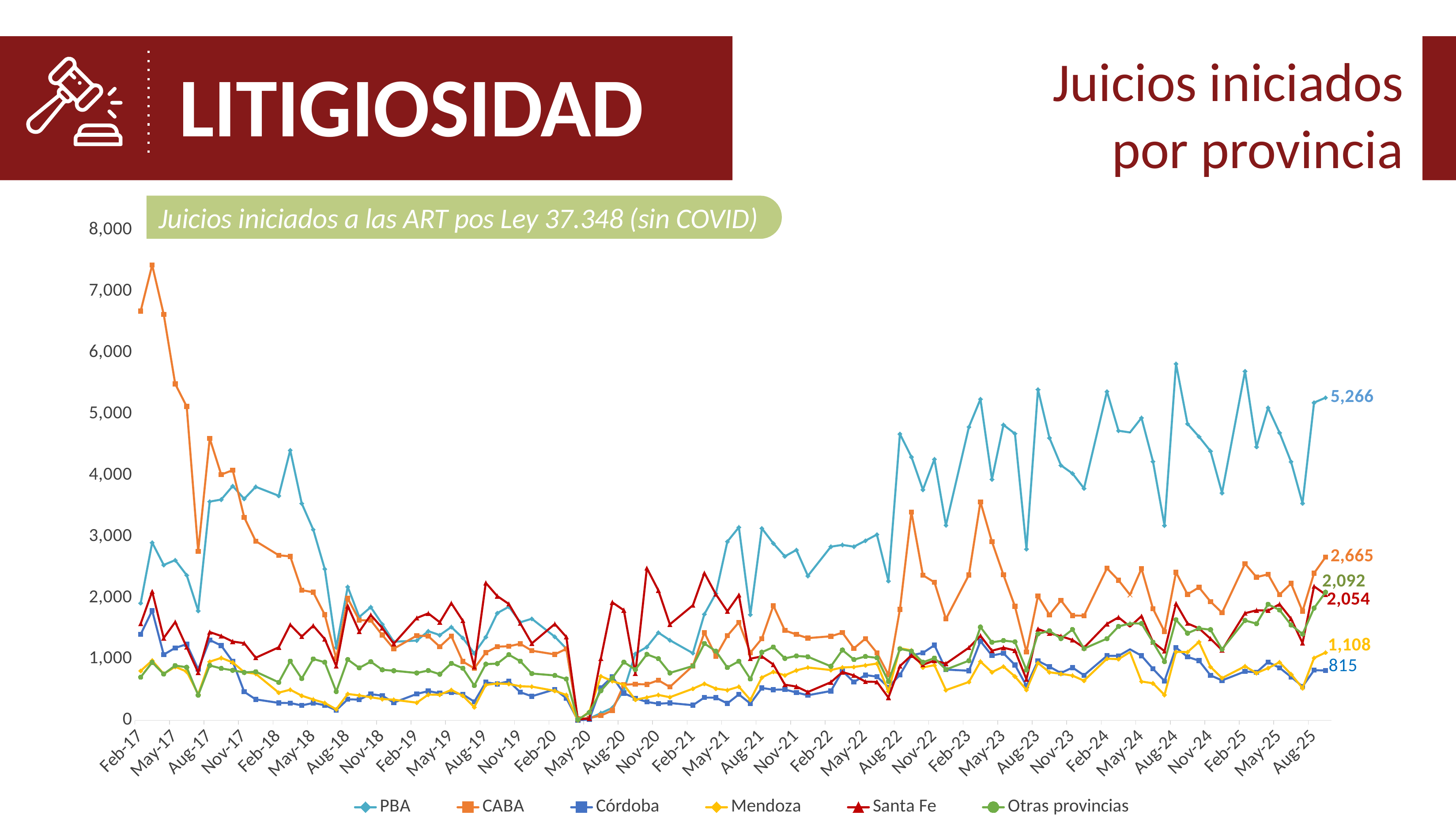
Is the value for CABA at Feb-17 greater or less than 6,000? greater At the last data point, which is larger: Otras provincias or Santa Fe? Otras provincias What is the value labelled at the end of the PBA line? 5,266 Does the CABA line overall rise or fall from Feb-17 to Aug-25? Fall Which series has the highest value at the last data point? PBA Which series has the lowest value at the last data point? Córdoba What is the difference between the final labelled values of PBA and CABA? 2,601 How many series does the legend list? 6 What kind of chart is shown on the slide? Line chart What is the value labelled at the end of the CABA line? 2,665 What is the value labelled at the end of the Córdoba line? 815 What is the value labelled at the end of the Mendoza line? 1,108